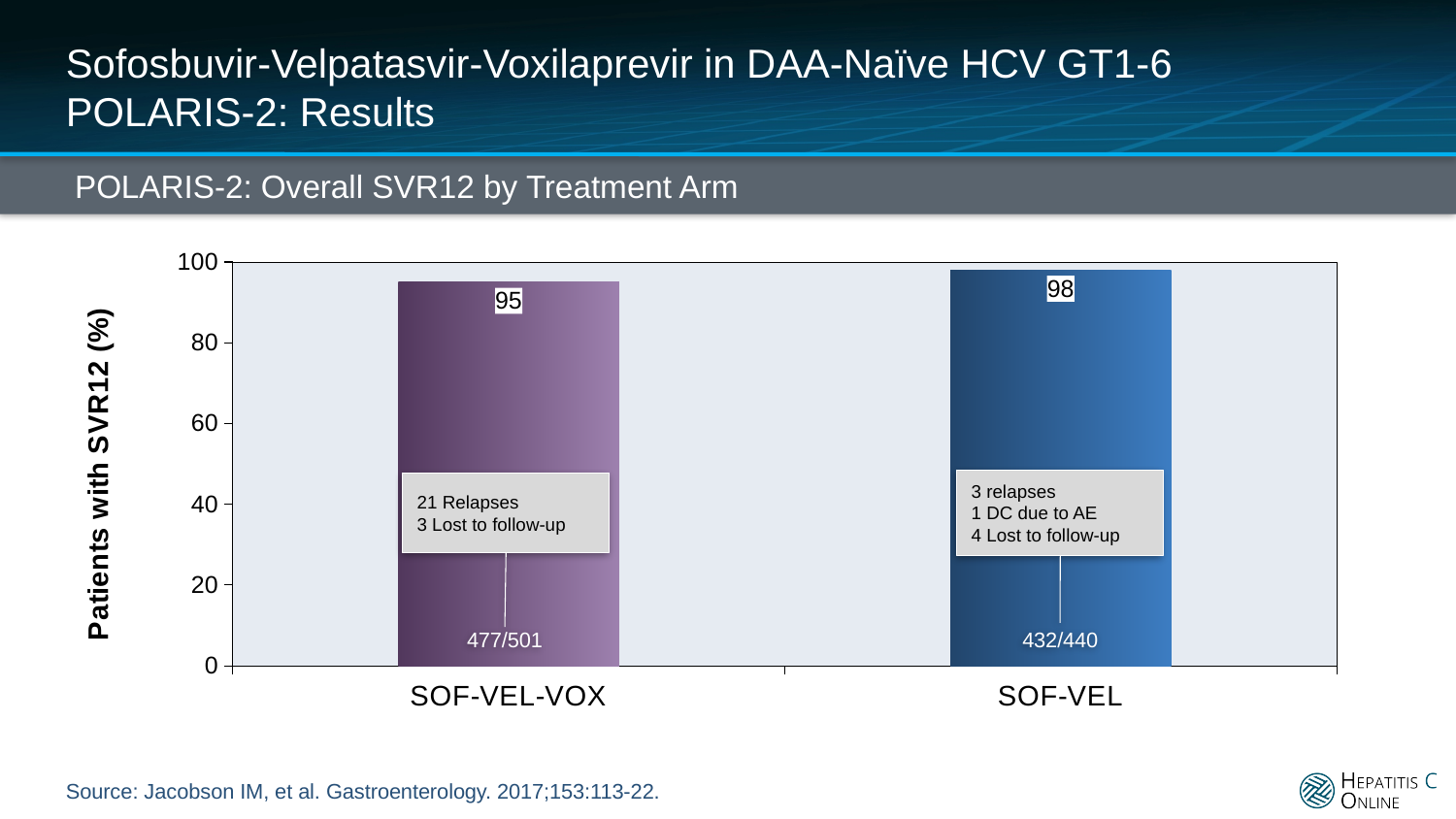
How many treatment arms are shown in the chart? 2 How many patients achieved SVR12 in the SOF-VEL-VOX arm, as a fraction of the total? 477/501 What is the difference in SVR12 rate between SOF-VEL and SOF-VEL-VOX? 3 Which treatment arm has the higher SVR12 rate? SOF-VEL What is the SVR12 rate for the SOF-VEL-VOX arm? 95 Which treatment arm has the lower SVR12 rate? SOF-VEL-VOX Is the SVR12 rate for SOF-VEL-VOX greater or less than 80? greater What is the SVR12 rate for the SOF-VEL arm? 98 What is the label of the y-axis? Patients with SVR12 (%) How many patients achieved SVR12 in the SOF-VEL arm, as a fraction of the total? 432/440 How many relapses occurred in the SOF-VEL-VOX arm? 21 What kind of chart is shown on the slide? Bar chart